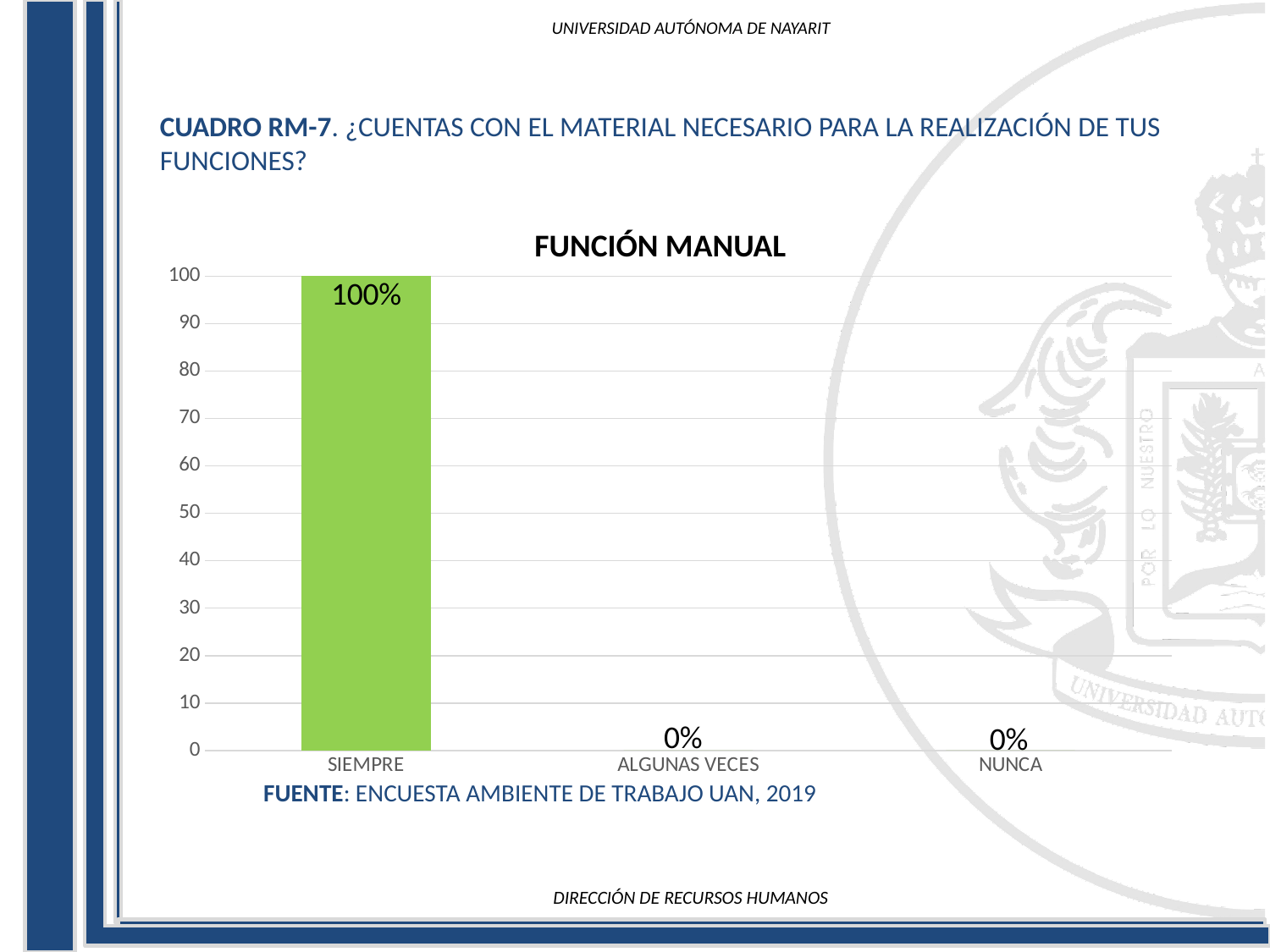
What kind of chart is shown on the slide? bar chart Is the value for SIEMPRE greater or less than 50? greater Which category has the highest value? SIEMPRE What is the title of the chart? FUNCIÓN MANUAL What is the difference between the values for SIEMPRE and NUNCA? 100% How many categories are shown on the x axis? 3 What is the value for NUNCA? 0% Which is larger, the value for SIEMPRE or the value for ALGUNAS VECES? SIEMPRE Do the values rise or fall from SIEMPRE to NUNCA along the x axis? fall What is the value for ALGUNAS VECES? 0% What colour is the bar for SIEMPRE? green What is the value for SIEMPRE? 100%